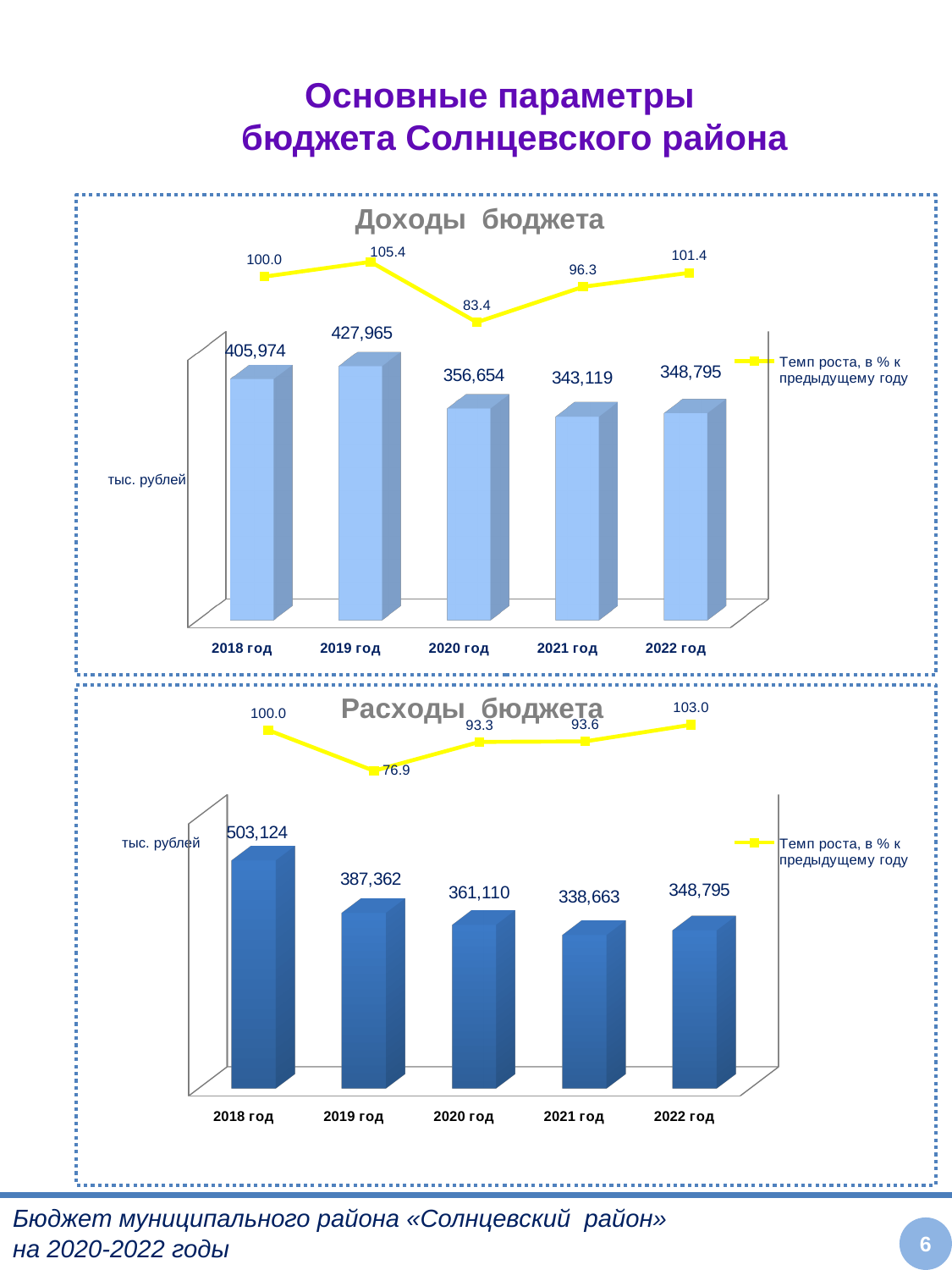
In the "Расходы бюджета" chart, which is larger: the bar for 2020 год or the bar for 2022 год? 2020 год In the "Расходы бюджета" chart, what is the difference between the 2018 год and 2019 год bar values? 115,762 In the "Расходы бюджета" chart, what is the value for 2018 год? 503,124 How many years are shown on the x axis of the "Доходы бюджета" chart? 5 In the "Доходы бюджета" chart, what is the growth rate (Темп роста) value for 2020 год? 83.4 In the "Доходы бюджета" chart, which year has the lowest bar? 2021 год In the "Доходы бюджета" chart, what is the value for 2019 год? 427,965 In the "Расходы бюджета" chart, which year has the lowest bar? 2021 год In the "Доходы бюджета" chart, what is the difference between the 2019 год and 2020 год bar values? 71,311 In the "Доходы бюджета" chart, which year has the highest bar? 2019 год What is the name of the line series shown in the legend of the "Расходы бюджета" chart? Темп роста, в % к предыдущему году In the "Расходы бюджета" chart, what is the growth rate (Темп роста) value for 2019 год? 76.9